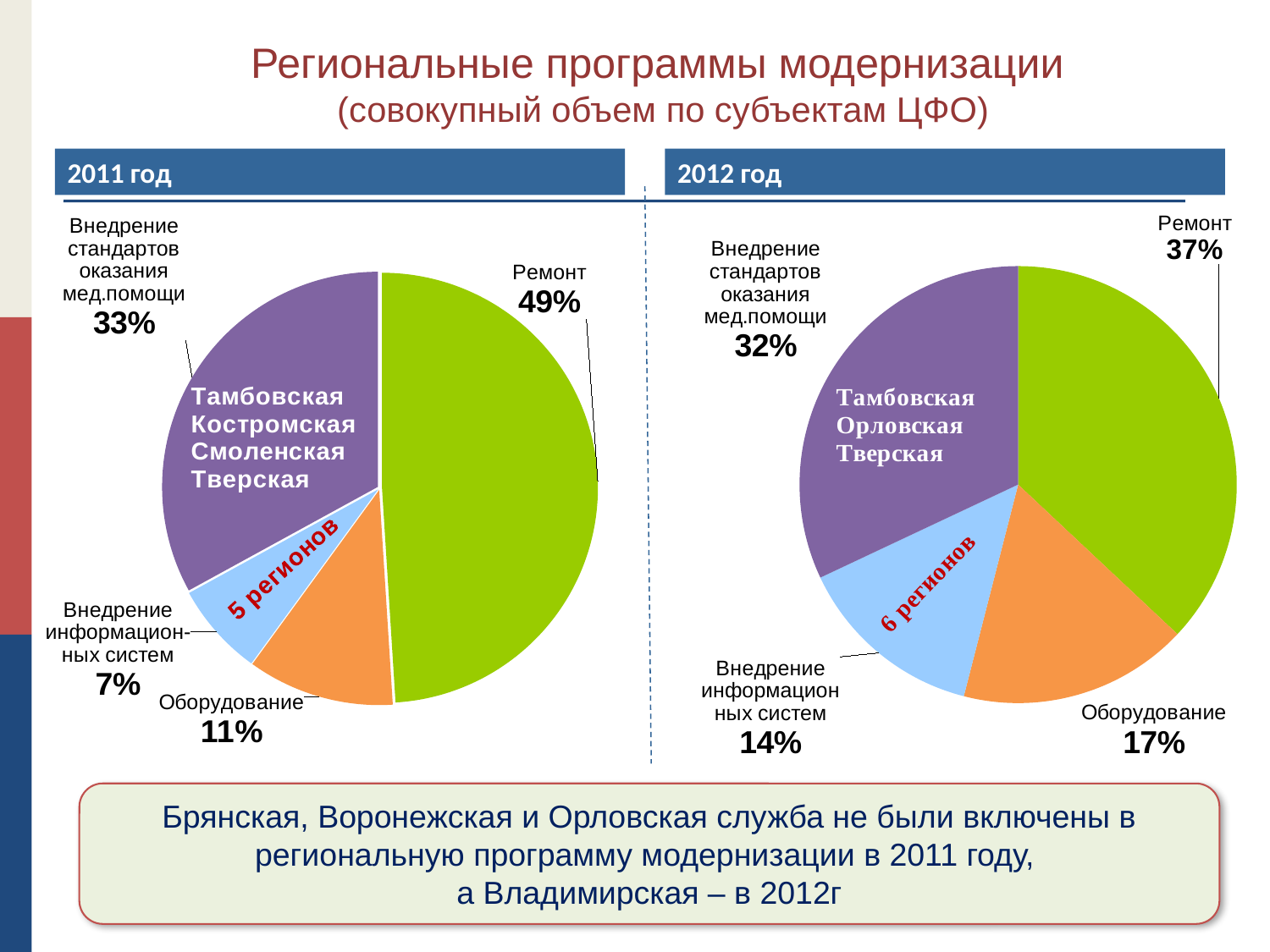
На диаграмме «2011 год» какая категория имеет наибольшую долю? Ремонт Сколько секторов на диаграмме «2012 год»? 4 Какого типа диаграммы показаны на слайде? Круговые диаграммы Какая доля «Ремонт» больше: на диаграмме «2011 год» или на диаграмме «2012 год»? 2011 год На диаграмме «2012 год» какая доля приходится на «Оборудование»? 17% На диаграмме «2012 год» какая доля приходится на «Внедрение стандартов оказания мед.помощи»? 32% На диаграмме «2012 год» на сколько процентных пунктов доля «Ремонт» больше доли «Оборудование»? 20 На диаграмме «2012 год» какая категория имеет наименьшую долю? Внедрение информационных систем На диаграмме «2011 год» на сколько процентных пунктов доля «Оборудование» больше доли «Внедрение информационных систем»? 4 Какие регионы перечислены внутри фиолетового сектора на диаграмме «2012 год»? Тамбовская, Орловская, Тверская На диаграмме «2011 год» какая доля приходится на «Ремонт»? 49% На диаграмме «2011 год» какая доля приходится на «Внедрение информационных систем»? 7%